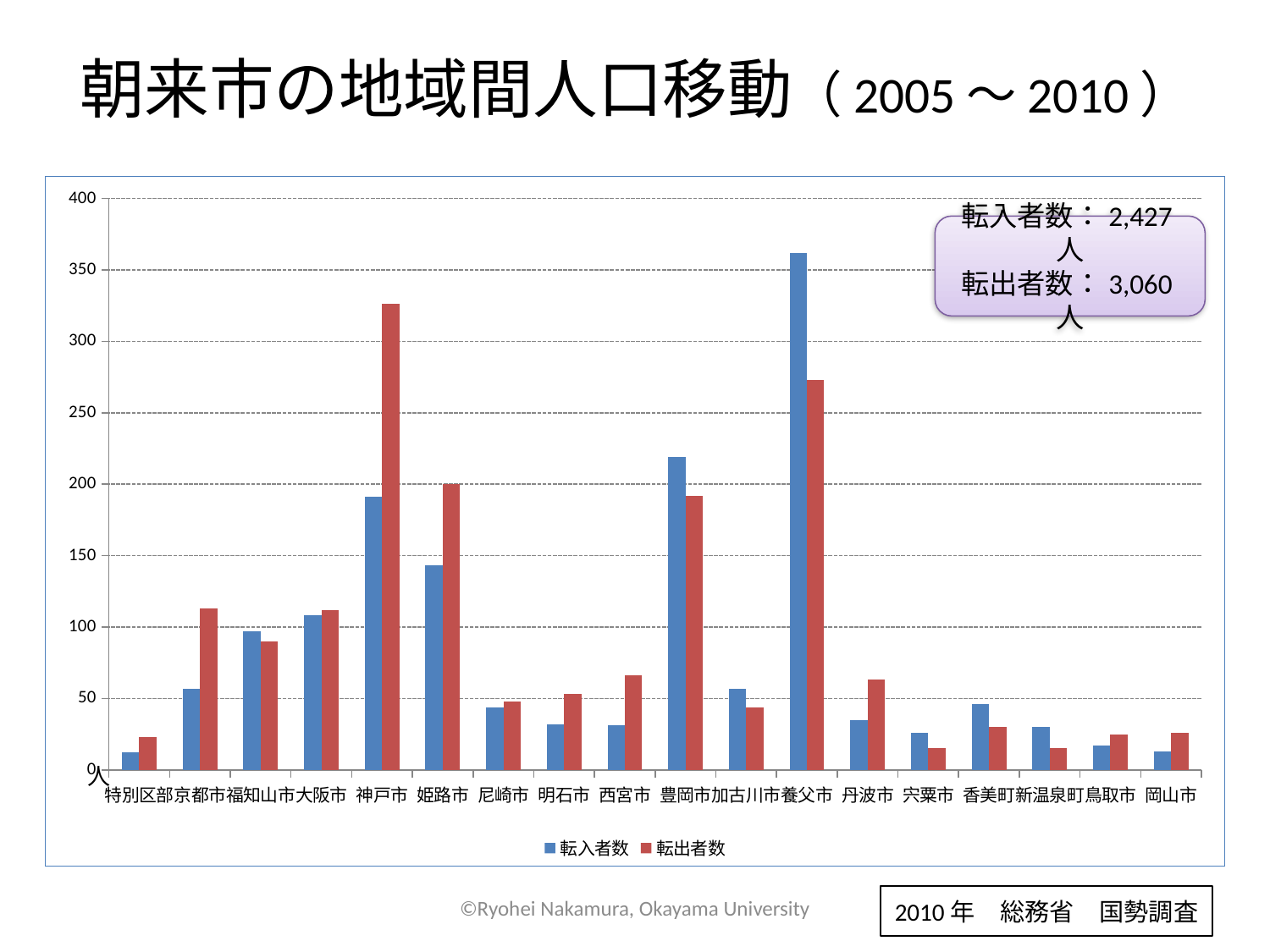
Is the 転入者数 value for 養父市 greater or less than 350? greater How many categories (municipalities) are shown on the x axis? 18 How many series does the legend list? 2 Is the 転出者数 value for 神戸市 greater or less than 300? greater For 豊岡市, which is larger, 転入者数 or 転出者数? 転入者数 Which category has the highest 転出者数 value? 神戸市 Is the 転入者数 value for 姫路市 greater or less than 150? less For 京都市, which is larger, 転入者数 or 転出者数? 転出者数 What total 転出者数 is stated in the text box on the chart? 3,060人 What kind of chart is shown on the slide? bar chart Which category has the highest 転入者数 value? 養父市